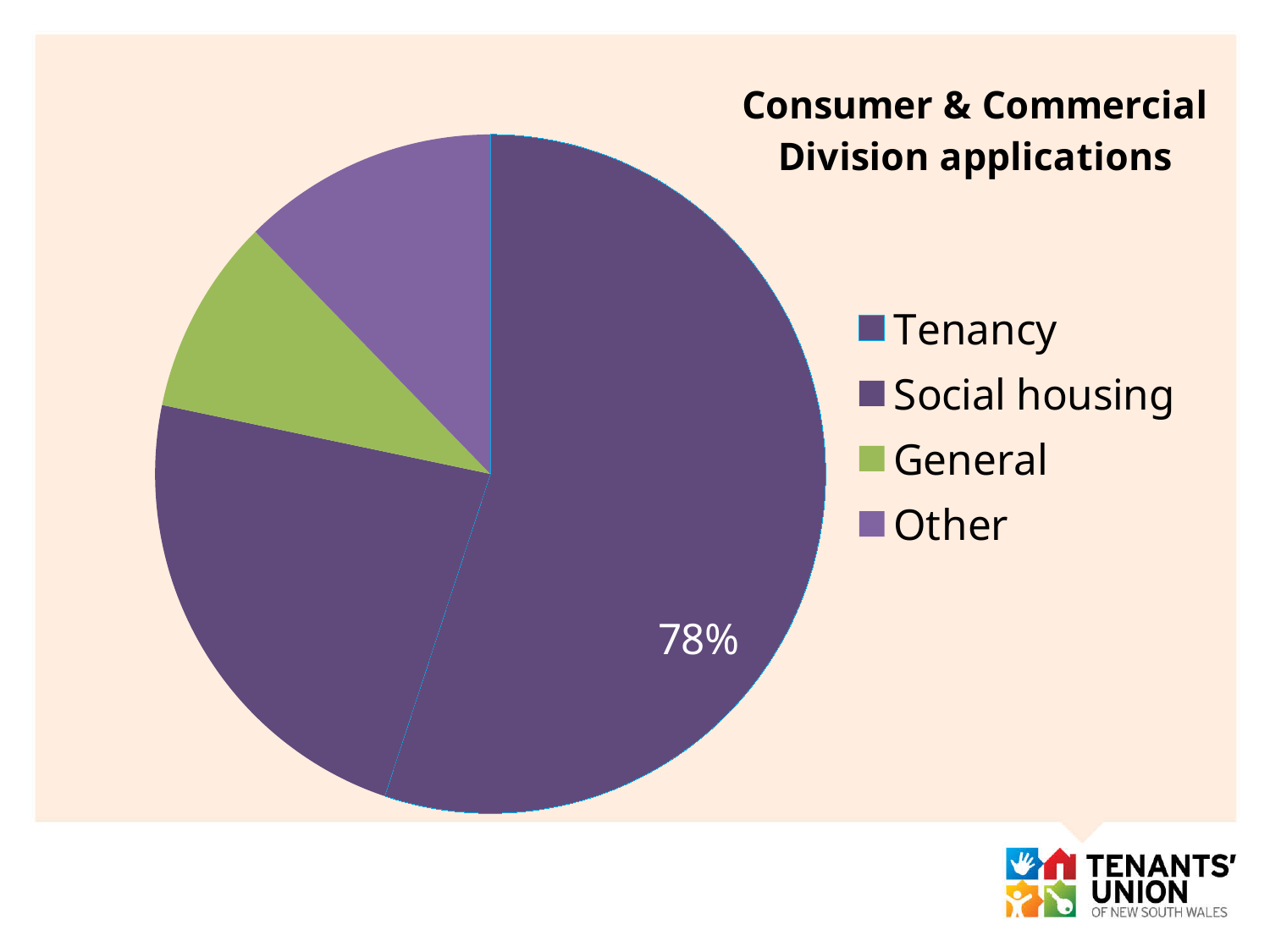
Which slice is larger, Tenancy or Social housing? Tenancy What kind of chart is shown on the slide? Pie chart Which slice is larger, Social housing or General? Social housing Which category is shown in green on the pie chart? General What is the title of the chart? Consumer & Commercial Division applications Which category has the largest slice of the pie? Tenancy What is the only percentage label printed on the pie chart? 78% How many categories does the legend of the pie chart list? 4 Which legend entry is listed last? Other Which slice is larger, Tenancy or Other? Tenancy